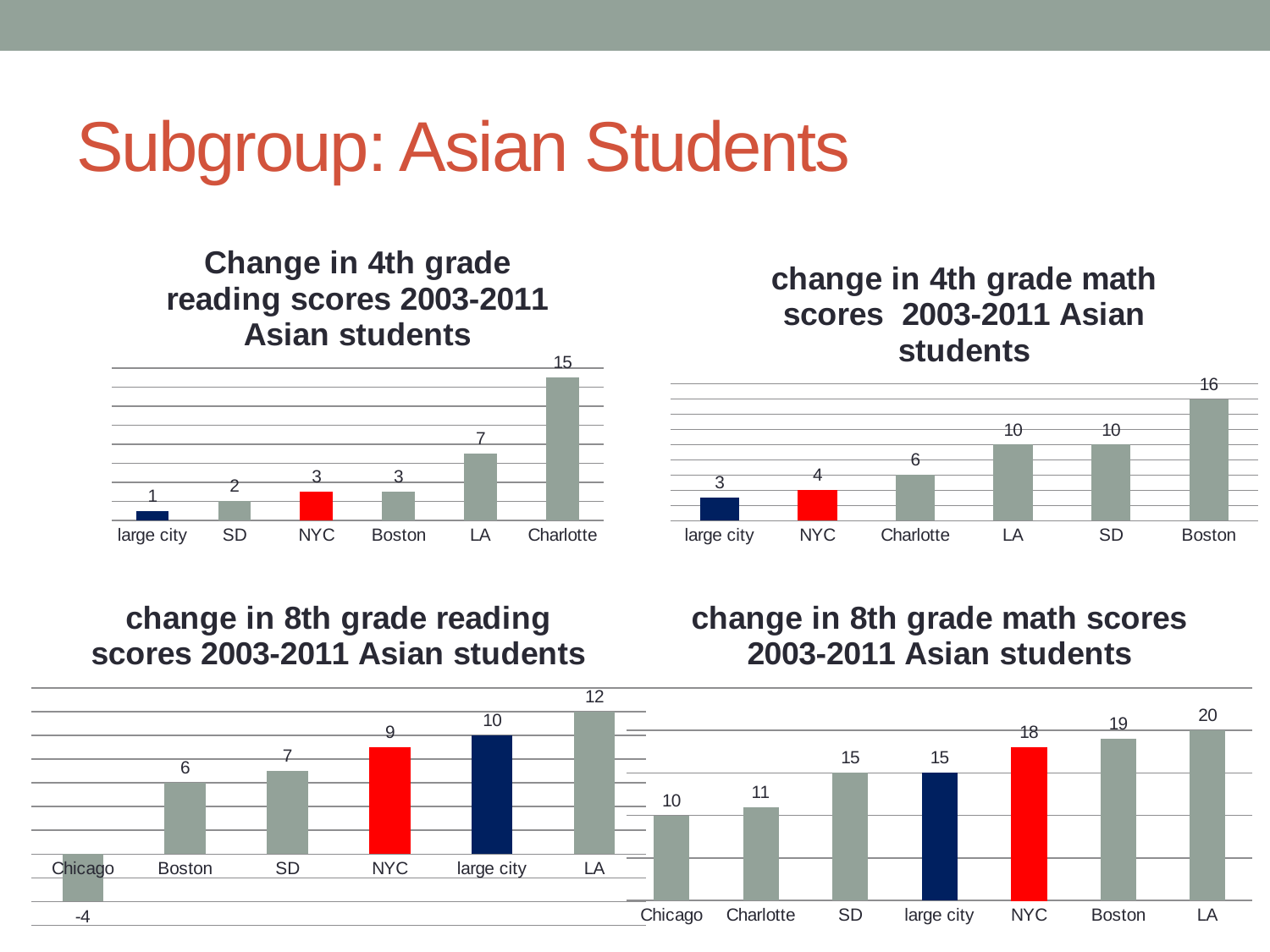
In the 'change in 4th grade math scores 2003-2011 Asian students' chart, what is the difference between the values for Boston and NYC? 12 In the 'change in 8th grade reading scores 2003-2011 Asian students' chart, which is larger, the value for NYC or the value for large city? large city In the 'Change in 4th grade reading scores 2003-2011 Asian students' chart, what is the value for Charlotte? 15 In the 'change in 8th grade reading scores 2003-2011 Asian students' chart, which category has the highest value? LA In the 'change in 8th grade reading scores 2003-2011 Asian students' chart, what is the value for Chicago? -4 In the 'Change in 4th grade reading scores 2003-2011 Asian students' chart, which category has the lowest value? large city In the 'change in 8th grade math scores 2003-2011 Asian students' chart, what is the value for NYC? 18 What type of chart is the 'change in 8th grade math scores 2003-2011 Asian students' chart? bar chart In the 'change in 4th grade math scores 2003-2011 Asian students' chart, how many categories are shown? 6 In the 'change in 8th grade math scores 2003-2011 Asian students' chart, how many categories are shown? 7 In the 'change in 4th grade math scores 2003-2011 Asian students' chart, what is the value for Boston? 16 In the 'change in 8th grade math scores 2003-2011 Asian students' chart, what is the difference between the values for LA and Chicago? 10